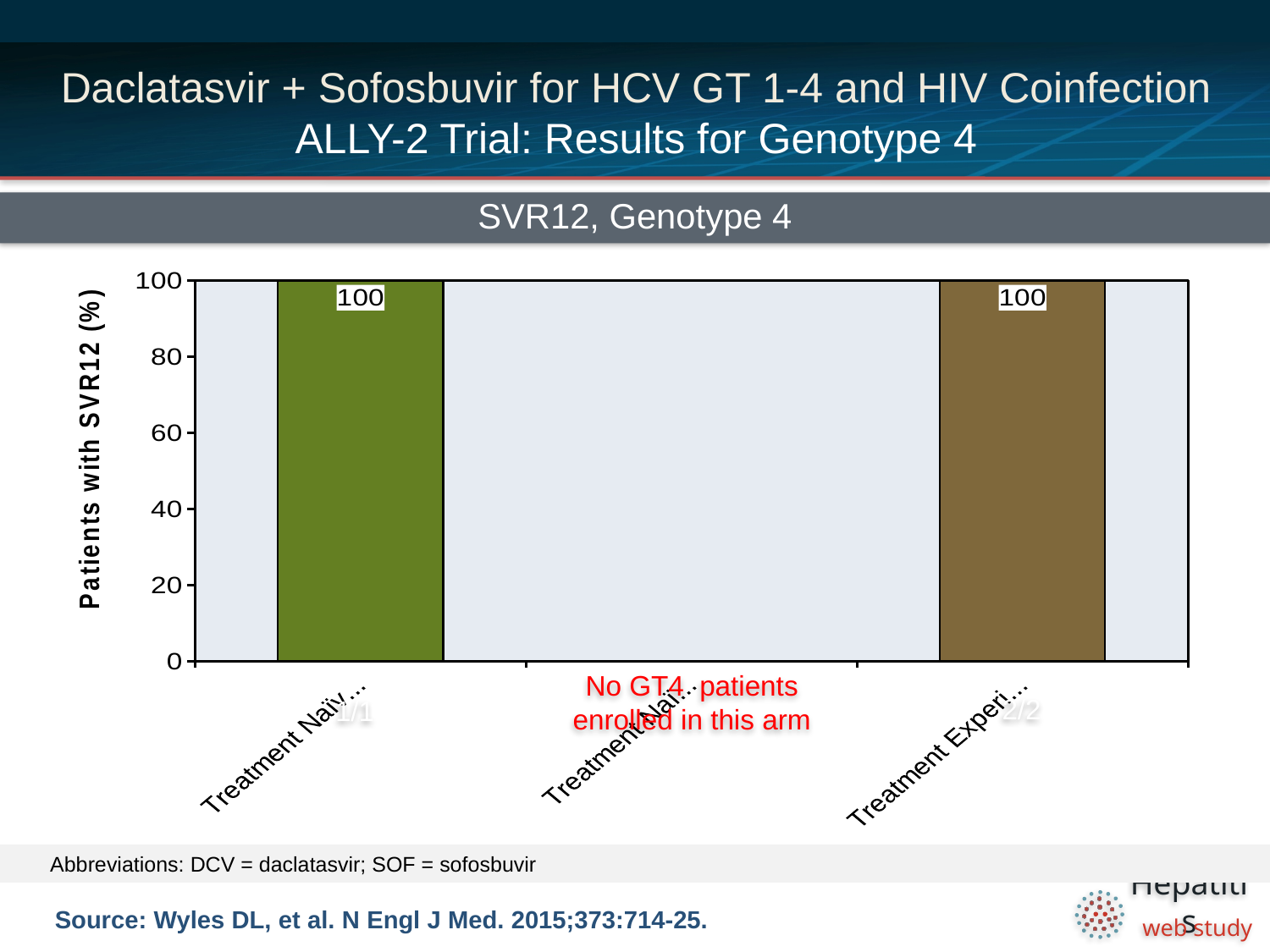
What is the highest value shown on the vertical axis? 100 Is the value of the rightmost bar greater or less than 60? greater Is the value of the leftmost bar greater or less than 80? greater What is the title of the chart? SVR12, Genotype 4 What value is printed on the leftmost (green) bar? 100 What is the difference between the value of the leftmost bar and the value of the rightmost bar? 0 Why is there no bar for the middle category of the chart? No GT4 patients enrolled in this arm What is the label on the vertical axis of the chart? Patients with SVR12 (%) What value is printed on the rightmost (brown) bar? 100 How many bars are plotted in the chart? 2 What kind of chart is shown on the slide? bar chart How many categories are shown along the x axis of the chart? 3